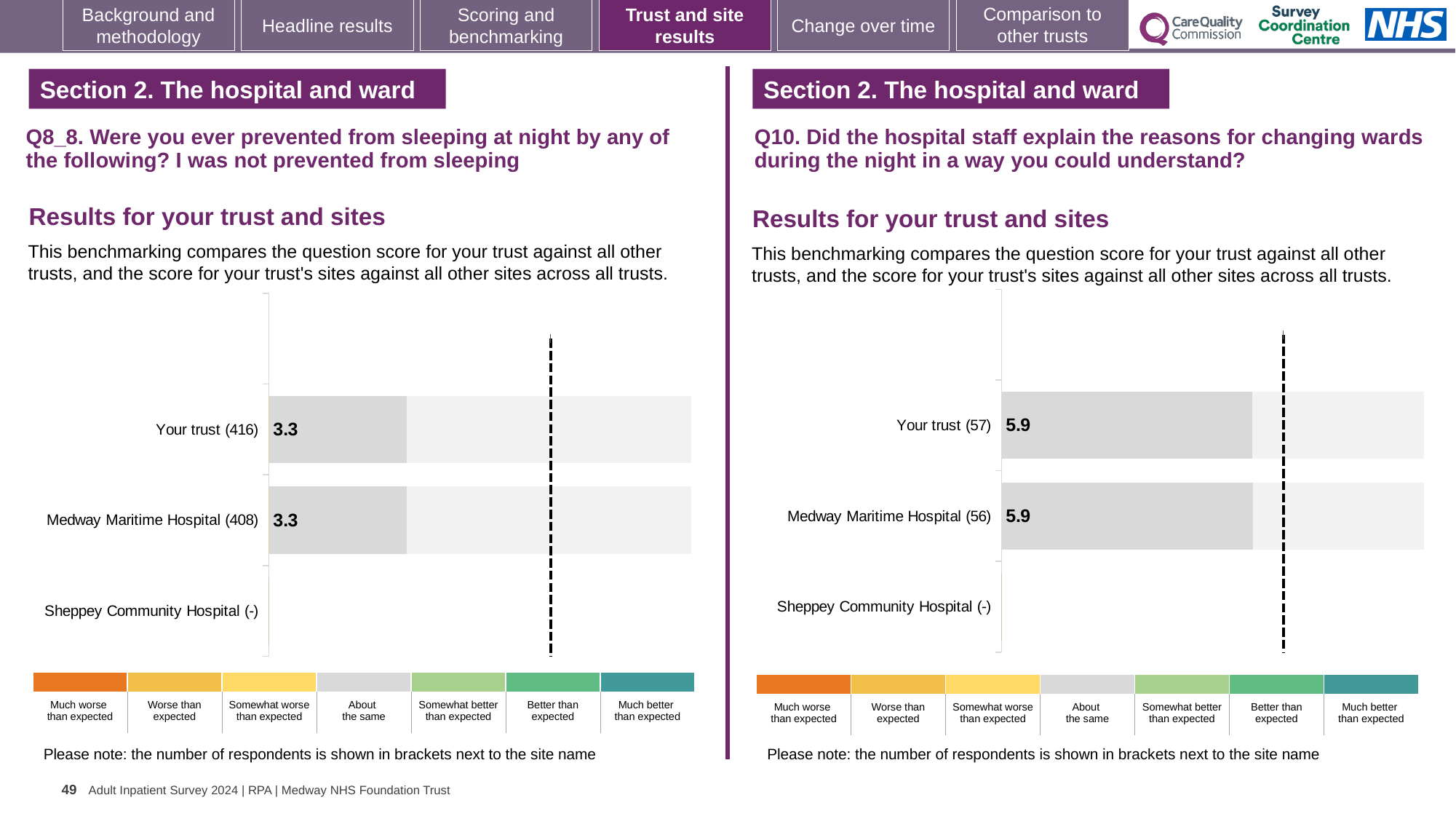
In the Q8_8 chart on the left, what is the score for Your trust? 3.3 What kind of chart is the Q8_8 chart on the left? Bar chart In the Q10 chart on the right, what is the score for Your trust? 5.9 In the Q10 chart on the right, what is the score for Medway Maritime Hospital? 5.9 In the Q10 chart on the right, what is the difference between the scores for Your trust and Medway Maritime Hospital? 0 In the Q8_8 chart on the left, what is the score for Medway Maritime Hospital? 3.3 How many site/trust categories are listed on the y axis of the Q10 chart on the right? 3 How many site/trust categories are listed on the y axis of the Q8_8 chart on the left? 3 In the Q10 chart on the right, how many respondents are shown in brackets for Medway Maritime Hospital? 56 In the Q10 chart on the right, which category has no score shown? Sheppey Community Hospital In the Q8_8 chart on the left, what is the difference between the scores for Your trust and Medway Maritime Hospital? 0 In the Q8_8 chart on the left, how many respondents are shown in brackets for Your trust? 416